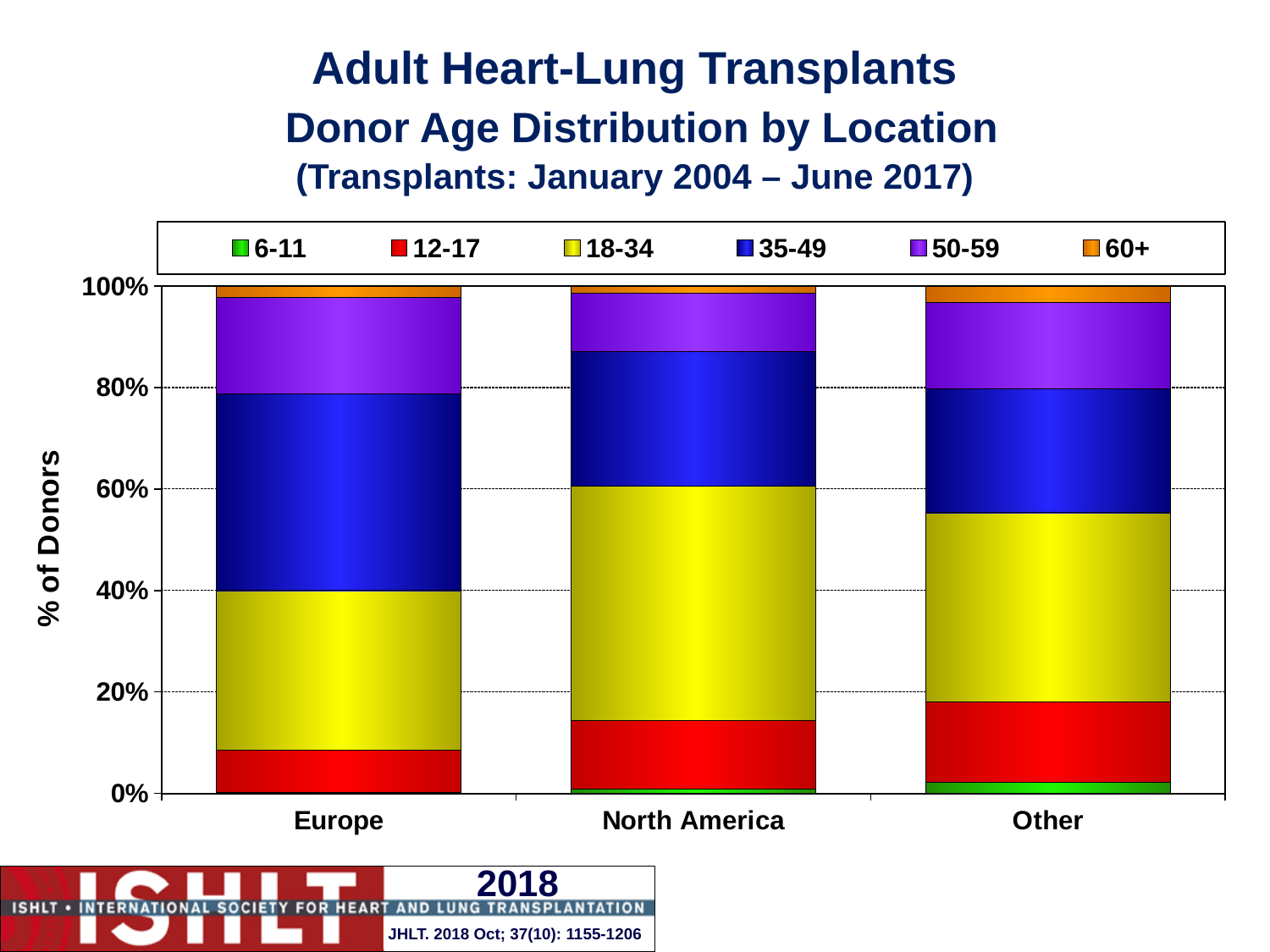
Is the 18-34 segment for North America greater or less than 40%? greater What kind of chart is shown on the slide? Stacked bar chart Which colour represents the 18-34 age group in the legend? Yellow Which location has the smallest 50-59 segment? North America Is the 35-49 segment larger for Europe or for North America? Europe Is the 35-49 segment for Europe greater or less than 20%? greater What is the label of the y axis? % of Donors Is the 12-17 segment for Other greater or less than 20%? less How many donor age groups does the legend list? 6 How many locations are shown on the x axis? 3 Which location has the largest 18-34 segment? North America